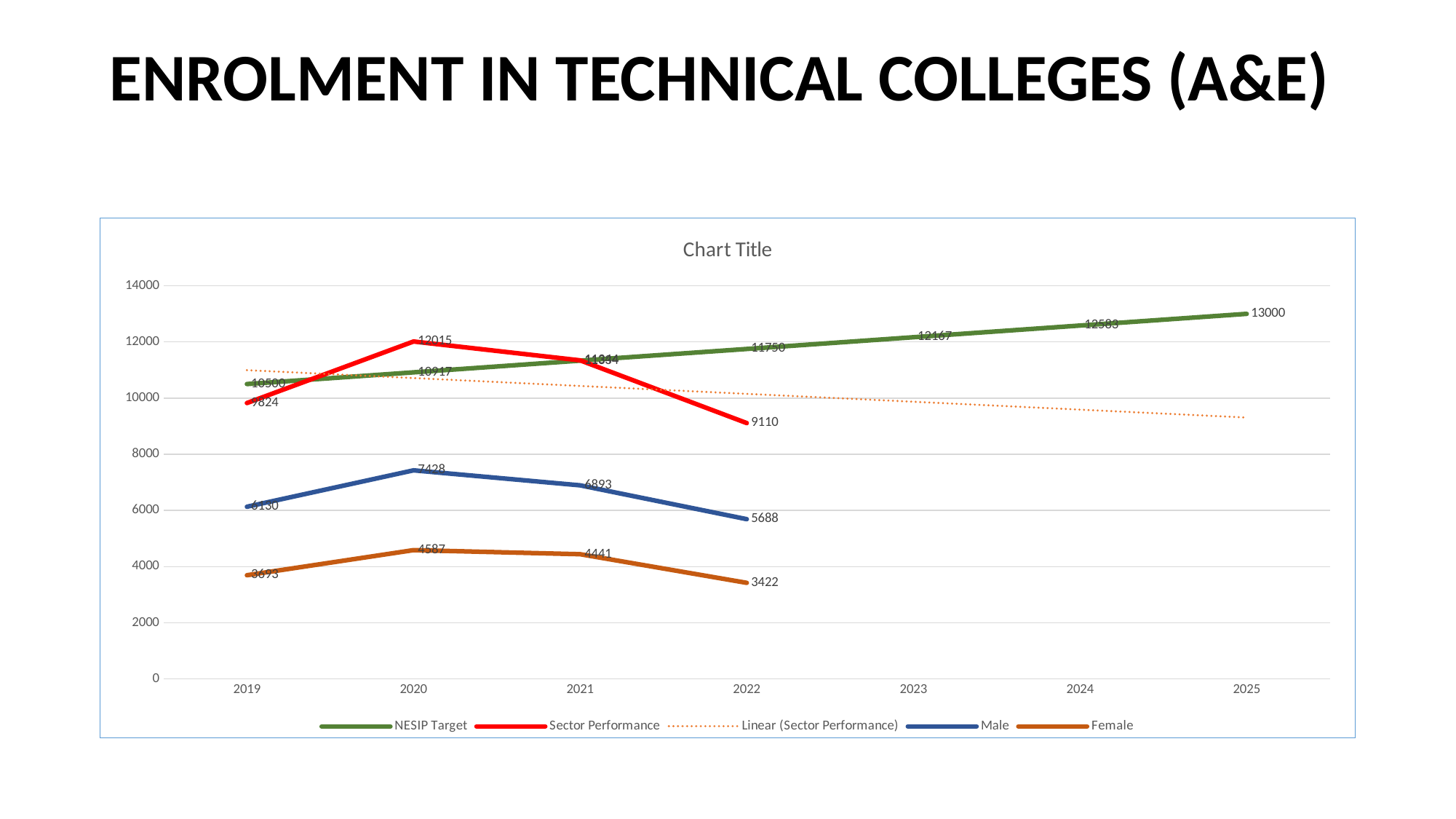
What is the Female value for 2020? 4587 Is the Sector Performance value for 2022 greater or less than 10000? less What is the NESIP Target value for 2025? 13000 How many series does the legend list? 5 What is the difference between the Male and Female values in 2022? 2266 What is the Sector Performance value for 2022? 9110 Does the NESIP Target line rise or fall from 2019 to 2025? rise What is the Male value for 2022? 5688 In which year is the Female value lowest? 2022 In which year is Sector Performance highest? 2020 What kind of chart is shown on the slide? line chart Which is larger, the Male value for 2020 or for 2021? 2020